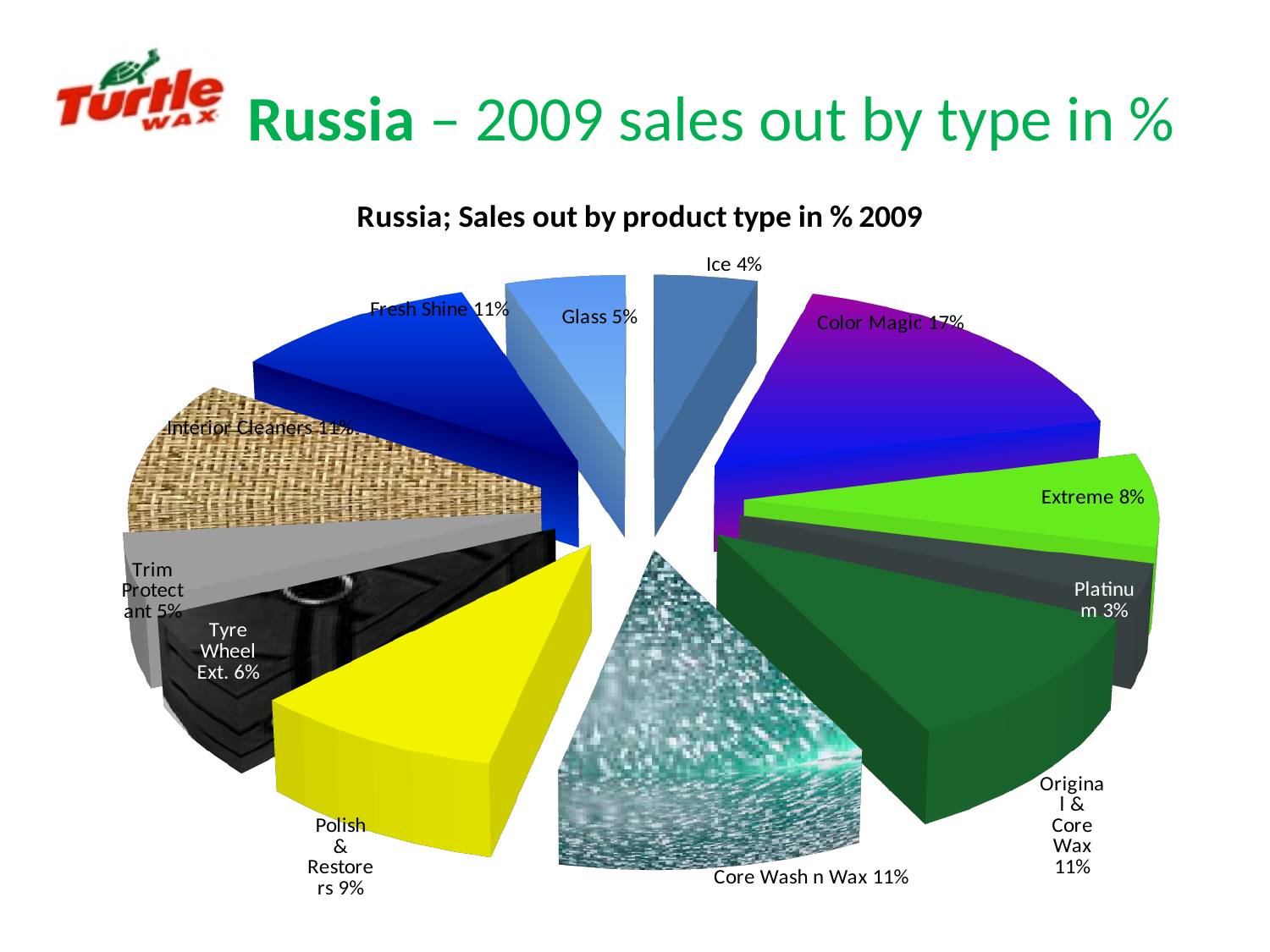
How many product types (slices) are shown in the pie chart? 12 How many percentage points larger is Color Magic's share than Ice's share? 13 What is the combined share of Fresh Shine and Interior Cleaners? 22% Which has a larger share, Extreme or Glass? Extreme What percentage of Russia's 2009 sales out is Color Magic? 17% What is the value shown for Polish & Restorers? 9% What kind of chart is shown on the slide? Pie chart What is the title of the chart? Russia; Sales out by product type in % 2009 Which product type has the largest share of sales out? Color Magic What percentage is shown for Tyre Wheel Ext.? 6% What share does Extreme have in the pie chart? 8% Which product type has the smallest share of sales out? Platinum